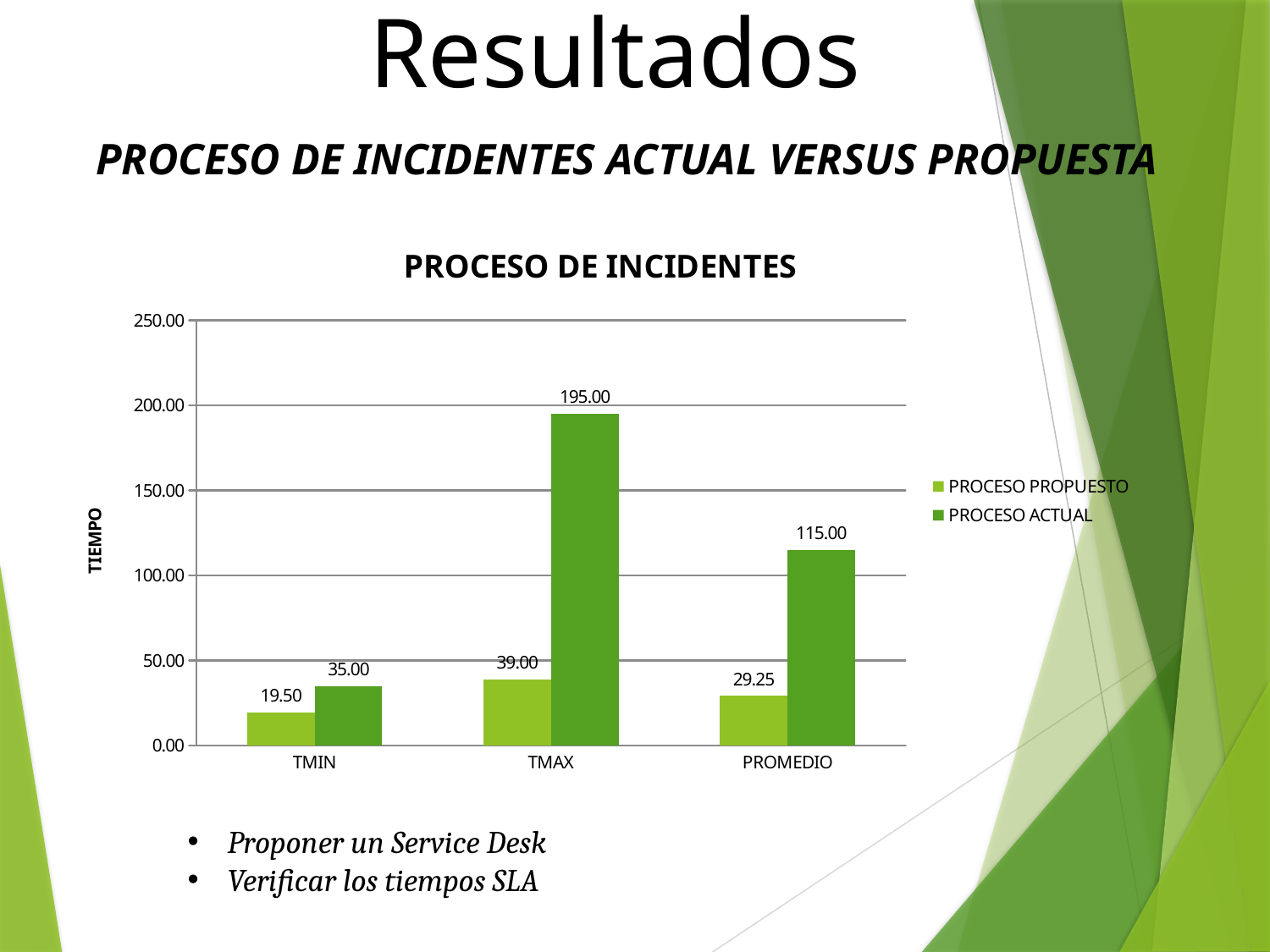
How many series does the legend list? 2 Which category has the lowest PROCESO PROPUESTO value? TMIN What is the value of PROCESO ACTUAL for TMAX? 195.00 What is the value of PROCESO PROPUESTO for TMIN? 19.50 Which is larger for PROMEDIO, PROCESO ACTUAL or PROCESO PROPUESTO? PROCESO ACTUAL What is the value of PROCESO PROPUESTO for PROMEDIO? 29.25 What is the difference between PROCESO ACTUAL and PROCESO PROPUESTO for TMAX? 156.00 Which category has the highest PROCESO ACTUAL value? TMAX How many categories are shown on the x axis? 3 What is the value of PROCESO ACTUAL for PROMEDIO? 115.00 What kind of chart is shown on the slide? Bar chart What is the difference between PROCESO ACTUAL and PROCESO PROPUESTO for TMIN? 15.50